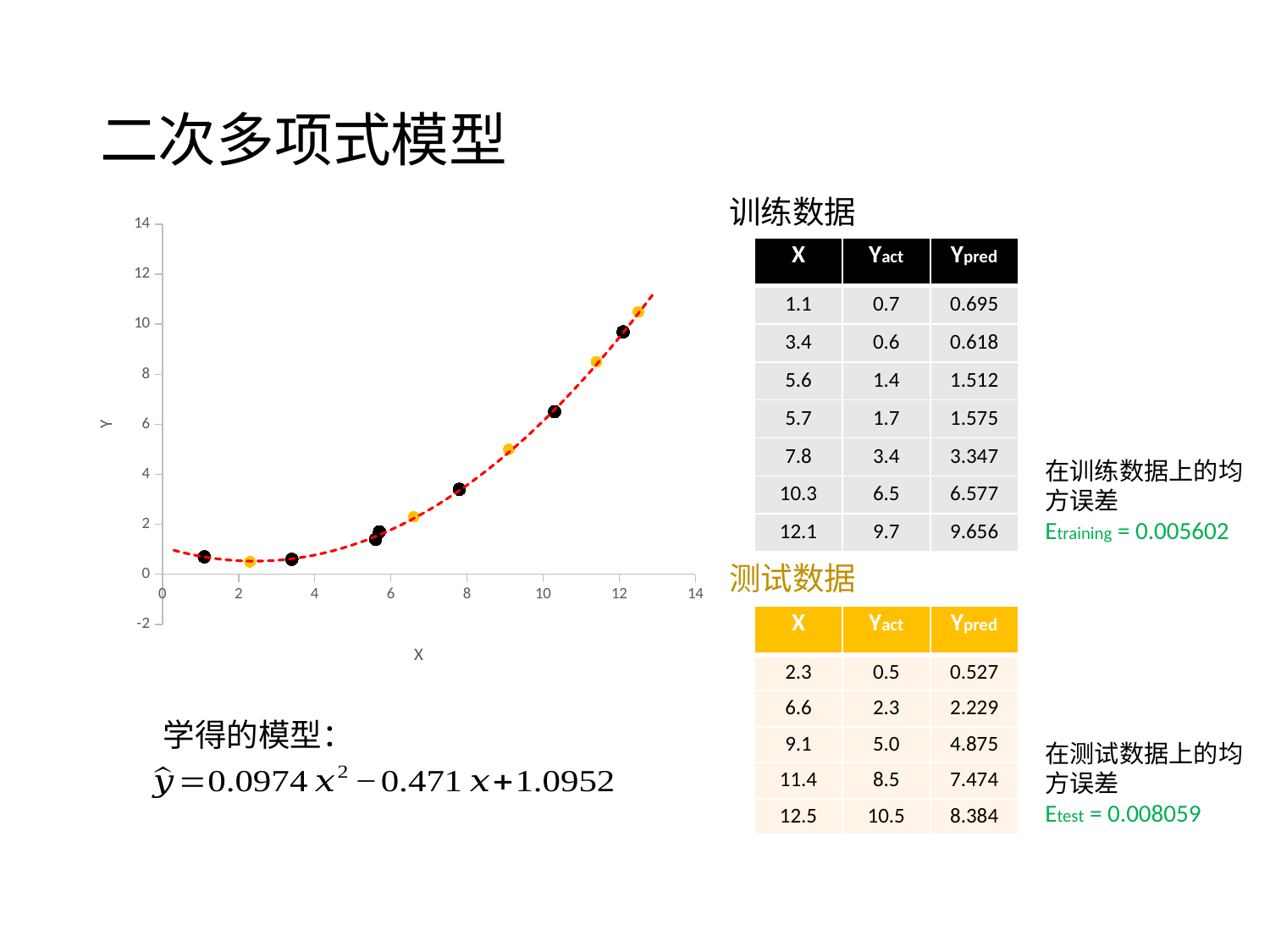
Is the Y value of the rightmost plotted point greater or less than 8? greater How many black data points are plotted on the chart? 7 Is the Y value of the plotted point near X = 8 greater or less than 4? less According to the training data table, what is the actual Y value (Yact) for X = 12.1? 9.7 What is the minimum value shown on the chart's Y axis? -2 How many yellow data points are plotted on the chart? 5 Which plotted point has the highest Y value, the one at X = 12.5 or the one at X = 12.1? X = 12.5 How many data points are plotted on the chart in total? 12 What is the maximum value shown on the chart's Y axis? 14 Do the plotted Y values generally rise or fall as X increases from 4 to 12? rise Is the Y value of the plotted point near X = 1 greater or less than 2? less What kind of chart is shown on the slide? scatter chart